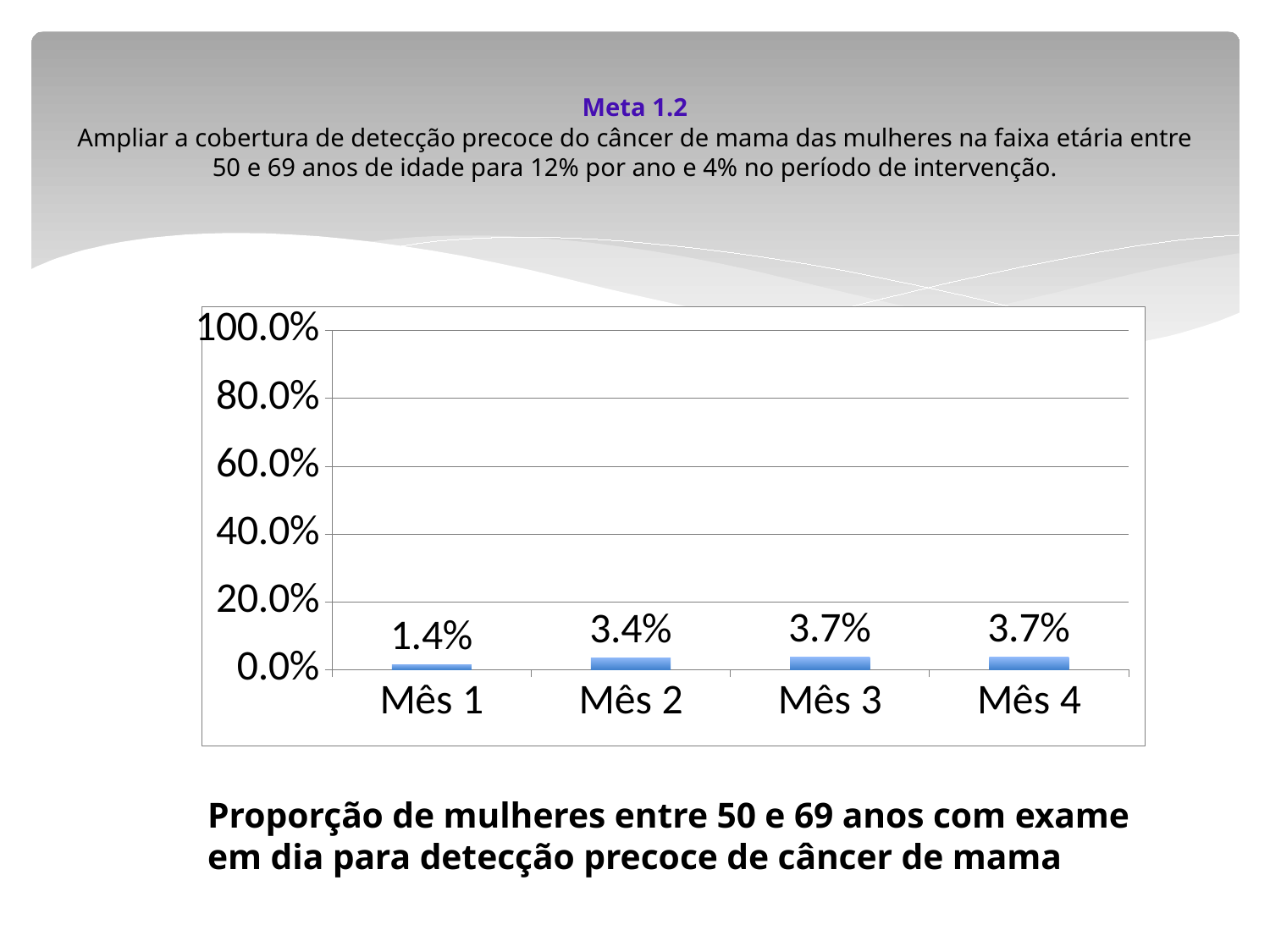
What is the value for Mês 3? 3.7% What is the value for Mês 1? 1.4% What is the difference between the values for Mês 2 and Mês 1? 2.0% What is the value for Mês 2? 3.4% How many months are shown on the x axis? 4 Which is larger, the value for Mês 2 or the value for Mês 1? Mês 2 Which month has the lowest value? Mês 1 What kind of chart is shown on the slide? bar chart What is the difference between the values for Mês 3 and Mês 2? 0.3% Is the value for Mês 4 greater or less than 20.0%? less What is the value for Mês 4? 3.7% Do the values rise or fall from Mês 1 to Mês 3? rise